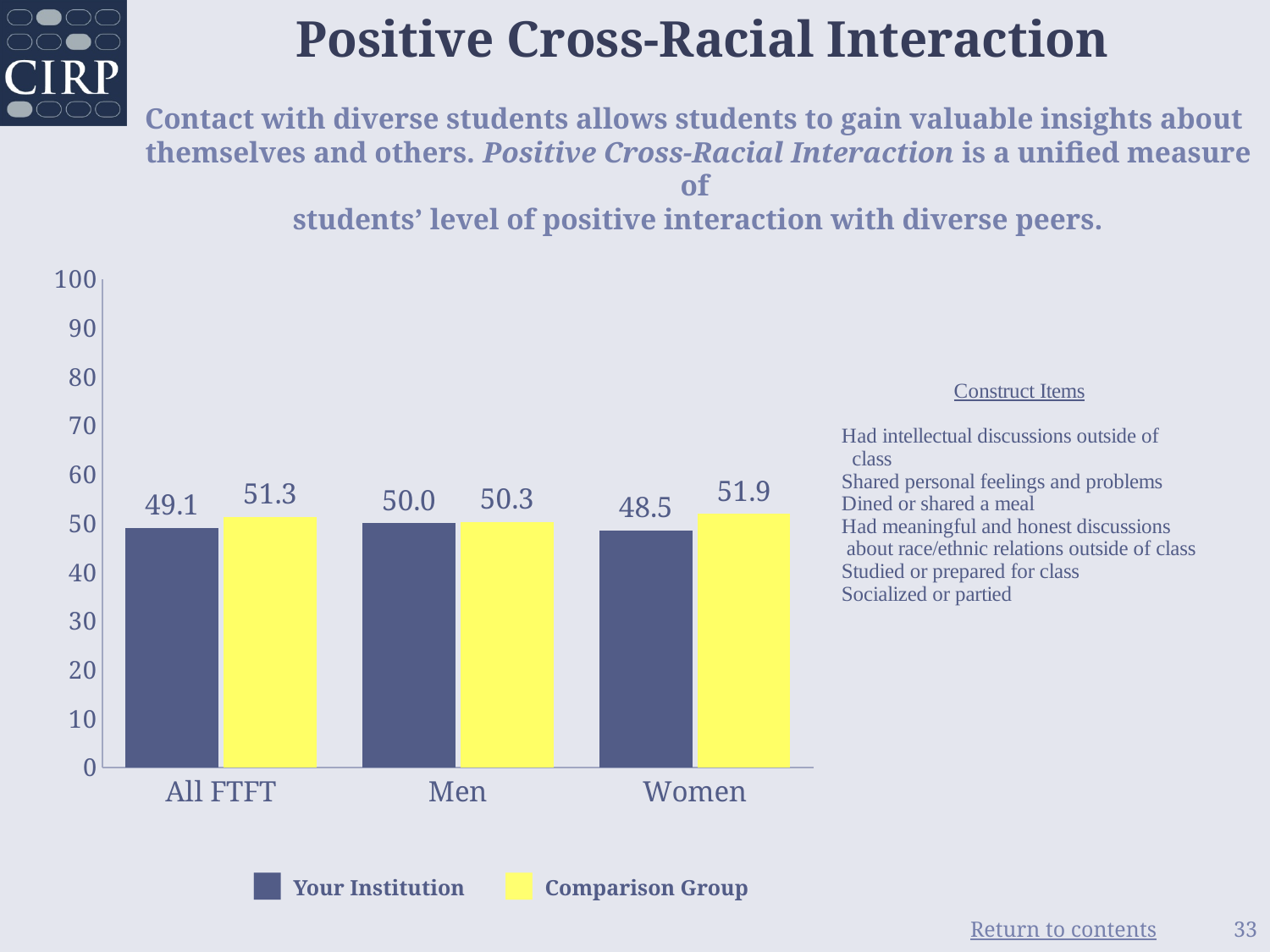
How many series does the legend list? 2 What is the difference between the Comparison Group and Your Institution values in the All FTFT category? 2.2 In the Women category, which is larger: Your Institution or the Comparison Group? Comparison Group What is the value for the Comparison Group in the Women category? 51.9 What is the difference between the Comparison Group and Your Institution values in the Women category? 3.4 What kind of chart is shown on the slide? Bar chart What is the value for Your Institution in the All FTFT category? 49.1 In which category does the Comparison Group have its highest value? Women What is the value for Your Institution in the Men category? 50.0 How many categories are shown on the x axis? 3 What is the value for the Comparison Group in the Men category? 50.3 In which category does Your Institution have its lowest value? Women